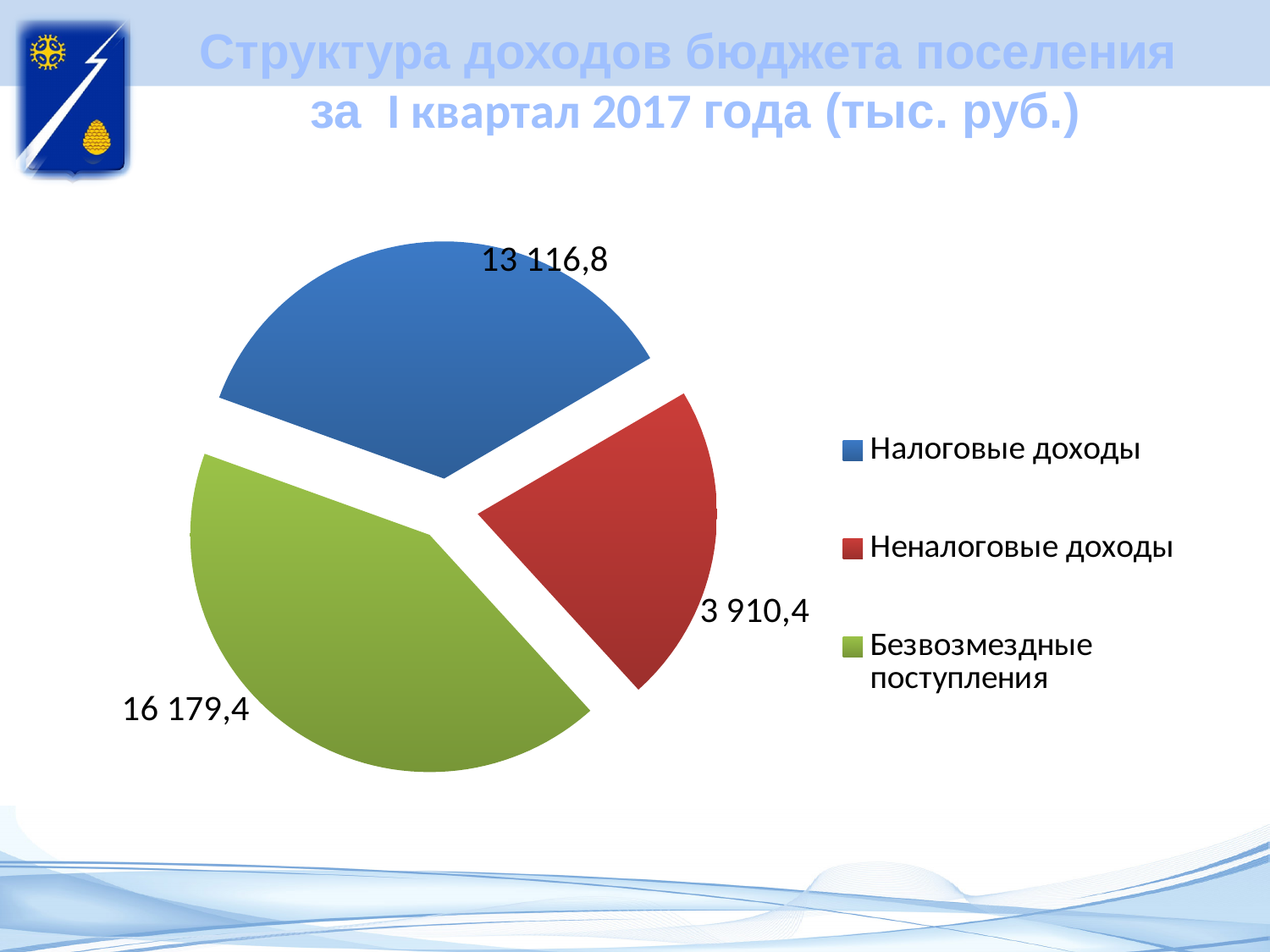
What is the value for Налоговые доходы? 13 116,8 Which category has the smallest value? Неналоговые доходы What is the value for Неналоговые доходы? 3 910,4 What is the difference between Налоговые доходы and Неналоговые доходы? 9 206,4 Which colour represents Неналоговые доходы in the legend? Red What is the total of all three slices? 33 206,6 What is the difference between Безвозмездные поступления and Налоговые доходы? 3 062,6 Which category has the largest value? Безвозмездные поступления Which is larger, Налоговые доходы or Неналоговые доходы? Налоговые доходы What is the value for Безвозмездные поступления? 16 179,4 What type of chart is shown on the slide? Pie chart How many categories does the pie chart have? 3